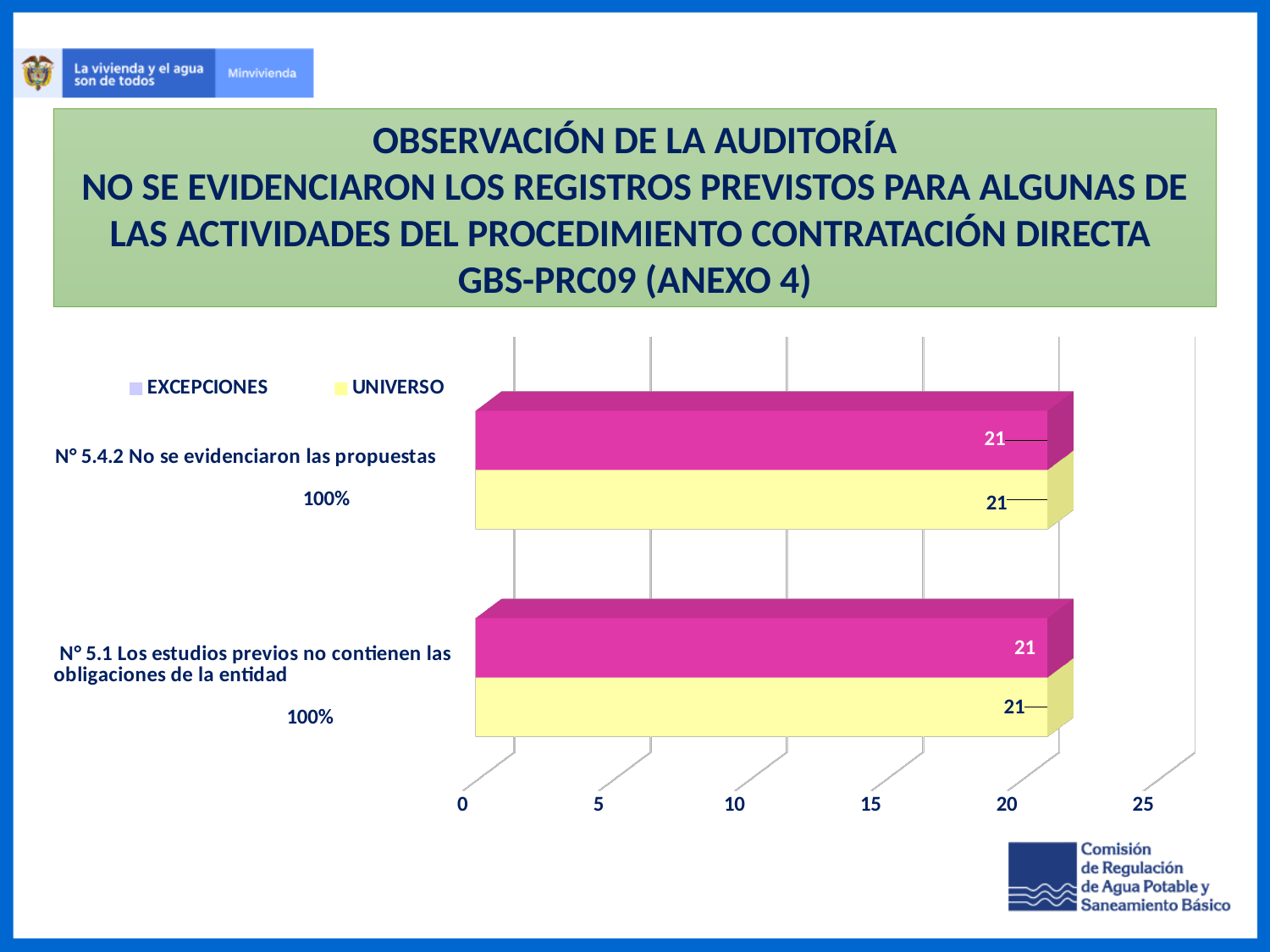
What is the EXCEPCIONES value for "N° 5.1 Los estudios previos no contienen las obligaciones de la entidad"? 21 What is the UNIVERSO value for "N° 5.1 Los estudios previos no contienen las obligaciones de la entidad"? 21 How many categories are plotted on the chart? 2 What kind of chart is shown on the slide? bar chart Is the EXCEPCIONES value for "N° 5.4.2 No se evidenciaron las propuestas" greater or less than 25? less Which series is shown in yellow in the chart legend? UNIVERSO How many series does the chart legend list? 2 What is the UNIVERSO value for "N° 5.4.2 No se evidenciaron las propuestas"? 21 What is the difference between the EXCEPCIONES and UNIVERSO values for "N° 5.4.2 No se evidenciaron las propuestas"? 0 Is the UNIVERSO value for "N° 5.1 Los estudios previos no contienen las obligaciones de la entidad" greater or less than 20? greater What is the EXCEPCIONES value for "N° 5.4.2 No se evidenciaron las propuestas"? 21 What percentage is printed under each category label on the chart? 100%